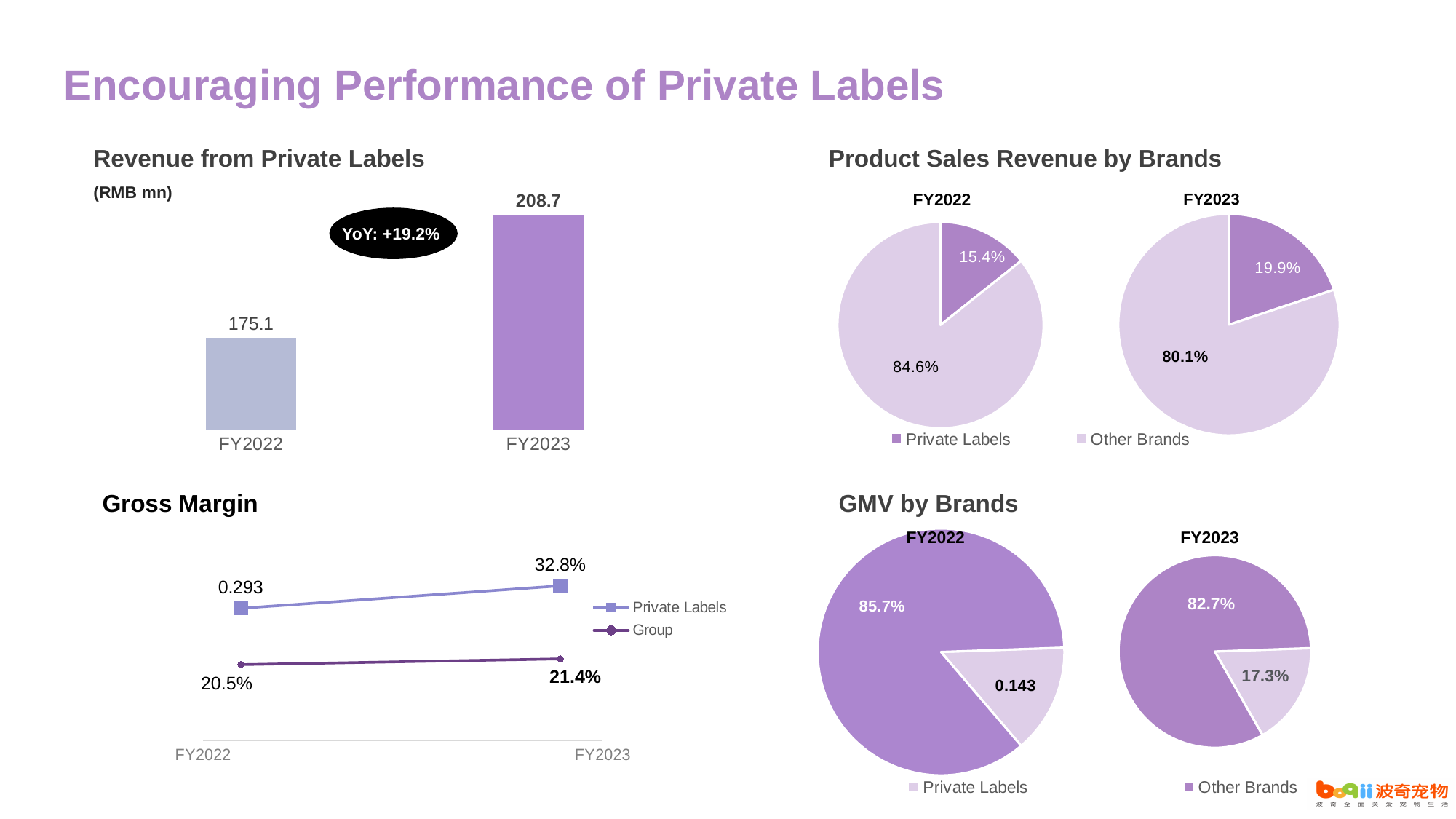
In the Gross Margin chart, what is the Group value for FY2022? 20.5% In the GMV by Brands FY2023 pie, what share do Other Brands have? 82.7% What kind of chart is the Revenue from Private Labels chart? Bar chart In the Gross Margin chart, what is the Private Labels value for FY2023? 32.8% In the Product Sales Revenue by Brands FY2023 pie, what share do Private Labels have? 19.9% In the Revenue from Private Labels chart, what YoY growth is shown in the callout? +19.2% In the Product Sales Revenue by Brands FY2022 pie, what share do Other Brands have? 84.6% In the Revenue from Private Labels chart, what is the value for FY2023? 208.7 In the Revenue from Private Labels chart, what is the value for FY2022? 175.1 In the Gross Margin chart, does the Group line rise or fall from FY2022 to FY2023? Rise In the Revenue from Private Labels chart, what is the difference between the FY2023 and FY2022 values? 33.6 How many series does the legend of the Gross Margin chart list? 2